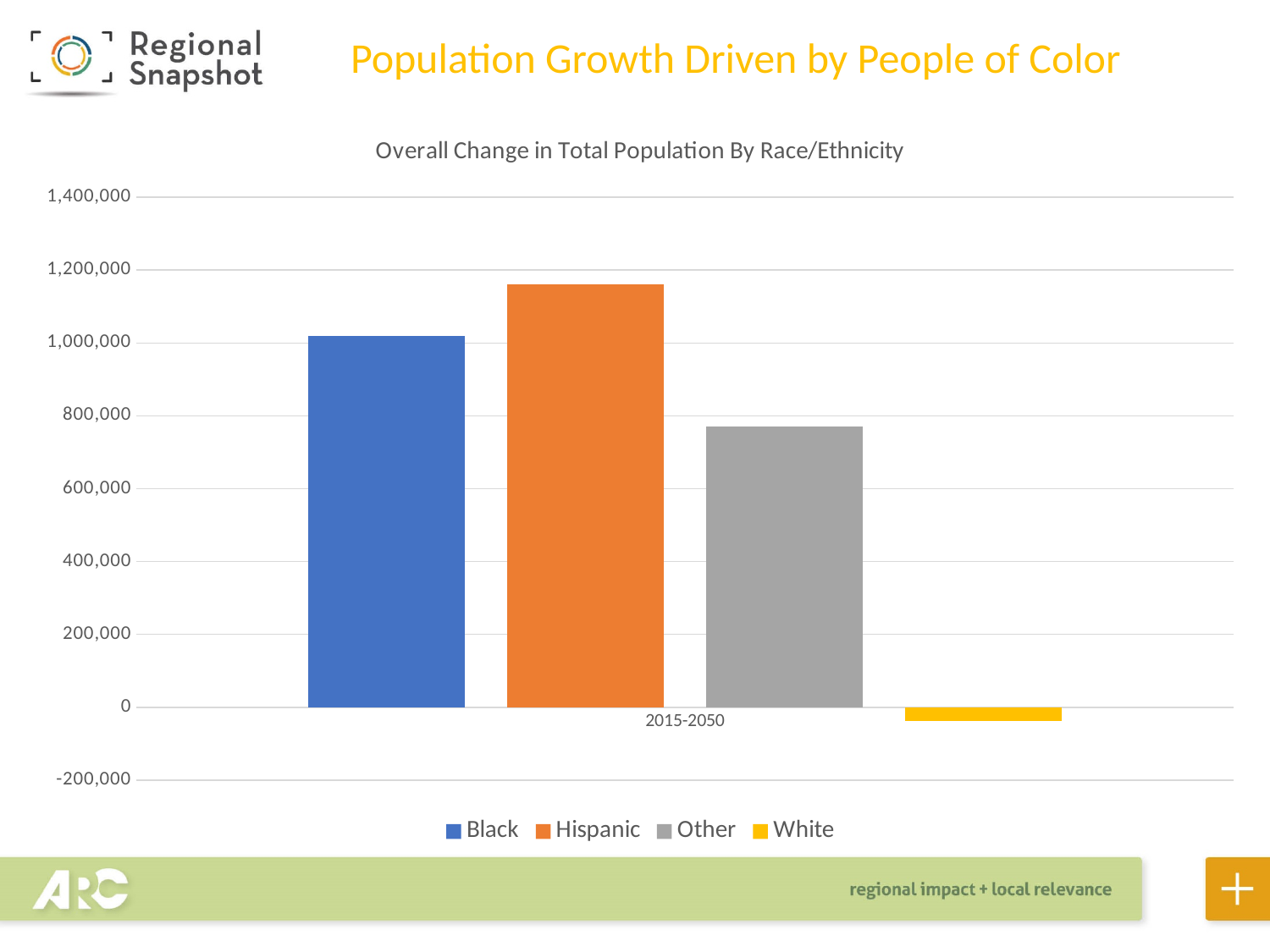
What is the title of the chart? Overall Change in Total Population By Race/Ethnicity Is the value for Hispanic greater or less than 1,000,000? greater Is the value for Black greater or less than 800,000? greater What kind of chart is shown on the slide? bar chart How many series does the legend list? 4 Which series has the highest value? Hispanic What period label appears on the x axis? 2015-2050 Is the value for Hispanic greater or less than 1,200,000? less Which series has the lowest value? White Which is larger, the value for Black or the value for Other? Black